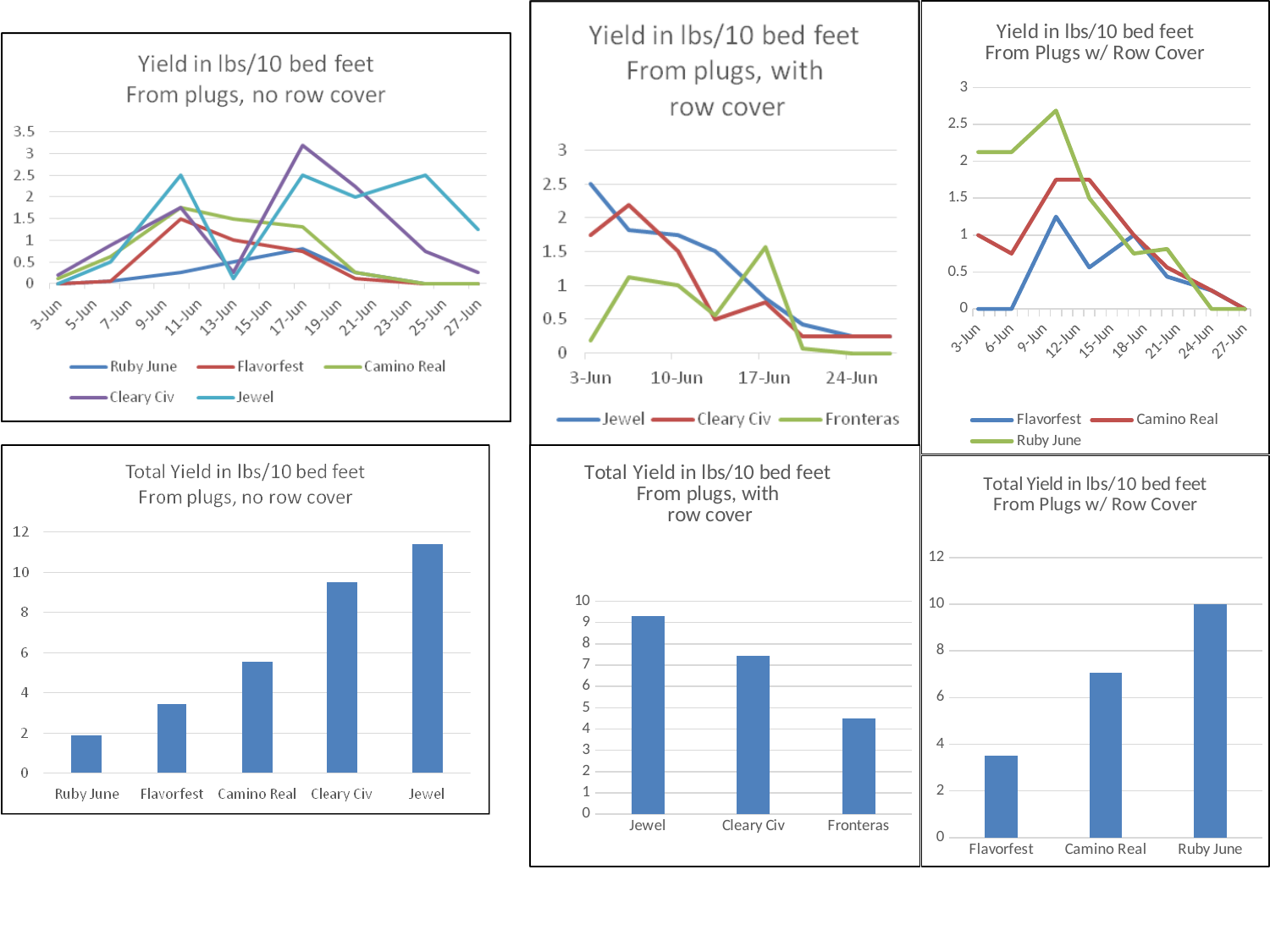
In the bottom-middle chart 'Total Yield in lbs/10 bed feet From plugs, with row cover', which variety has the highest total yield? Jewel How many series does the legend list in the top-middle chart 'Yield in lbs/10 bed feet From plugs, with row cover'? 3 In the bottom-middle chart 'Total Yield in lbs/10 bed feet From plugs, with row cover', is the value for Fronteras greater or less than 5? less In the bottom-right chart 'Total Yield in lbs/10 bed feet From Plugs w/ Row Cover', is the value for Flavorfest greater or less than 4? less In the bottom-left chart 'Total Yield in lbs/10 bed feet From plugs, no row cover', which variety has the highest total yield? Jewel In the bottom-left chart 'Total Yield in lbs/10 bed feet From plugs, no row cover', which variety has the lowest total yield? Ruby June How many series does the legend list in the top-left chart 'Yield in lbs/10 bed feet From plugs, no row cover'? 5 How many varieties are shown in the bottom-left chart 'Total Yield in lbs/10 bed feet From plugs, no row cover'? 5 In the bottom-right chart 'Total Yield in lbs/10 bed feet From Plugs w/ Row Cover', which has the larger total yield, Ruby June or Flavorfest? Ruby June In the bottom-middle chart 'Total Yield in lbs/10 bed feet From plugs, with row cover', which variety has the lowest total yield? Fronteras In the top-middle chart 'Yield in lbs/10 bed feet From plugs, with row cover', does the Jewel series rise or fall from 3-Jun to 24-Jun? fall What kind of chart is the top-middle chart 'Yield in lbs/10 bed feet From plugs, with row cover'? line chart